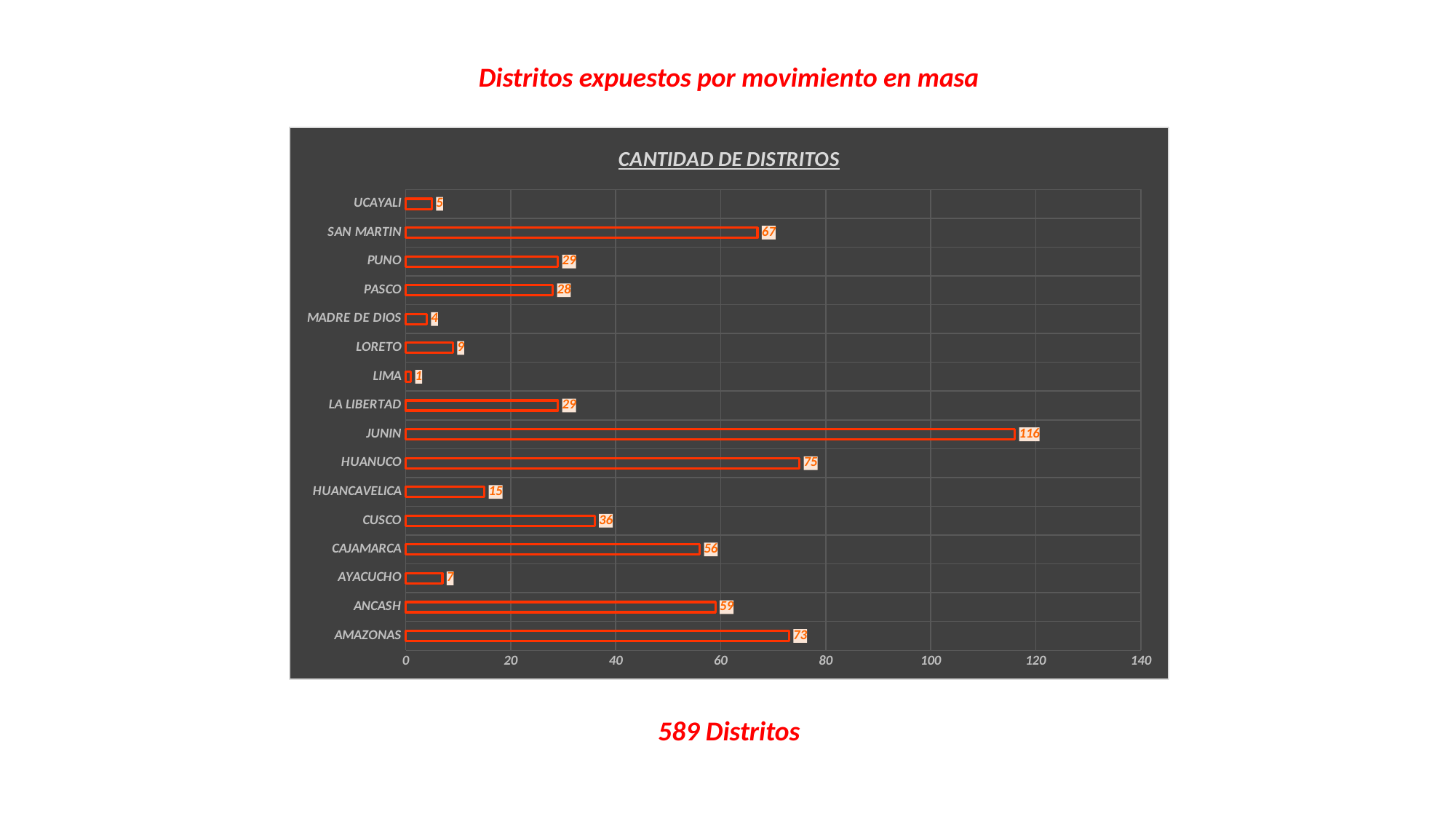
Which category has the highest value? JUNIN How many categories are shown in the chart? 16 What is the value for MADRE DE DIOS? 4 Which is larger, the value for SAN MARTIN or the value for ANCASH? SAN MARTIN What is the difference between the values for HUANUCO and AMAZONAS? 2 What is the value for JUNIN? 116 Which category has the lowest value? LIMA What is the maximum value shown on the x axis? 140 Is the value for CUSCO greater or less than 40? less What is the title of the chart? CANTIDAD DE DISTRITOS What is the value for CAJAMARCA? 56 What kind of chart is shown on the slide? bar chart